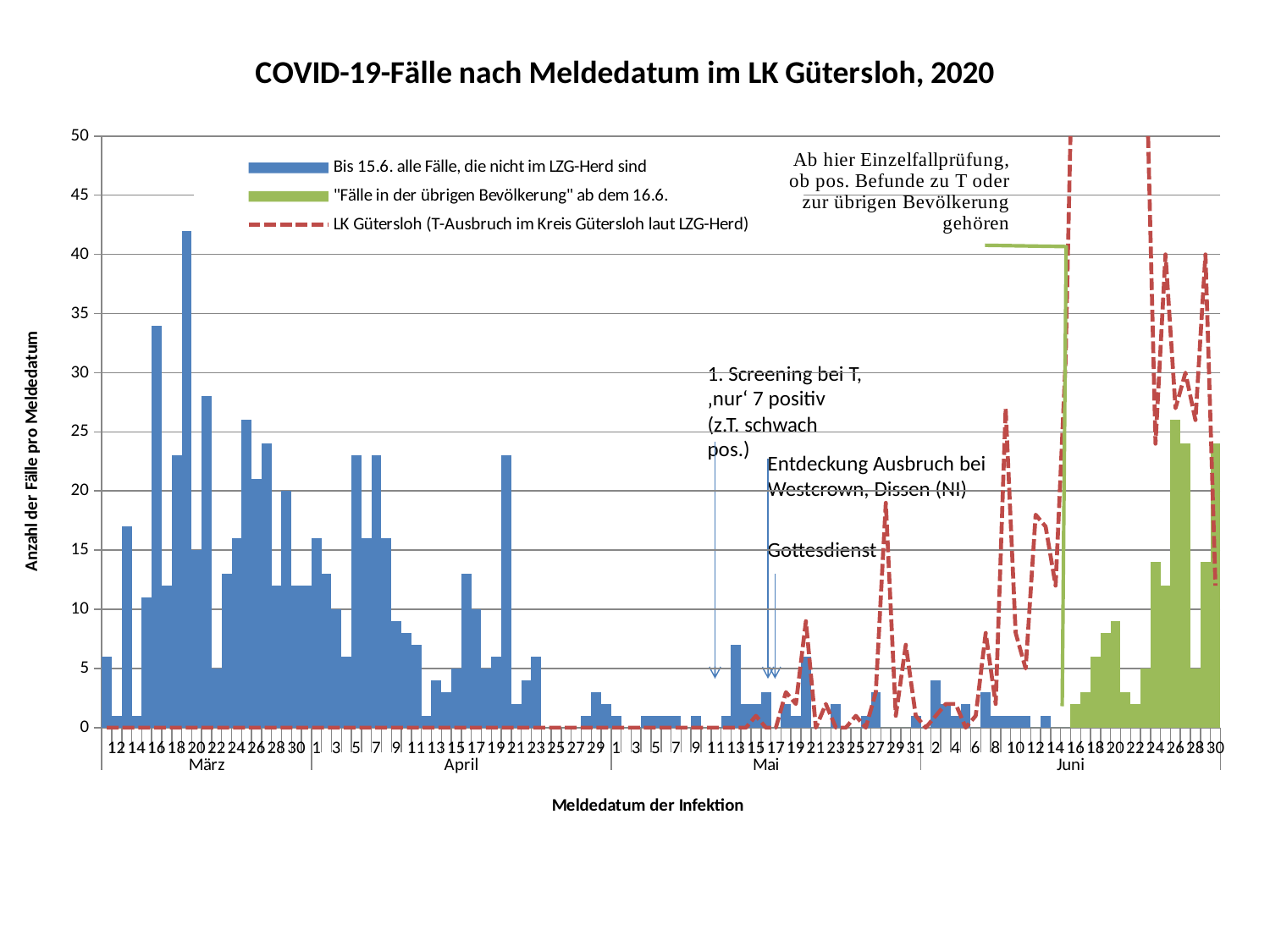
Do the blue bars generally rise or fall from late March through April? fall Is the tallest blue bar greater or less than 40? greater Is the tallest green bar greater or less than 20? greater How many series does the legend list? 3 Which is taller, the tallest blue bar or the tallest green bar? the tallest blue bar How many months are labelled on the x axis? 4 In which month does the tallest blue bar occur? März Is the highest peak of the red dashed line greater or less than 45? greater What is the title of the vertical axis? Anzahl der Fälle pro Meldedatum Do the green bars generally rise or fall from 16 June to 26 June? rise What kind of chart is shown on the slide? bar chart with a dashed line series Which series is drawn as a red dashed line according to the legend? LK Gütersloh (T-Ausbruch im Kreis Gütersloh laut LZG-Herd)